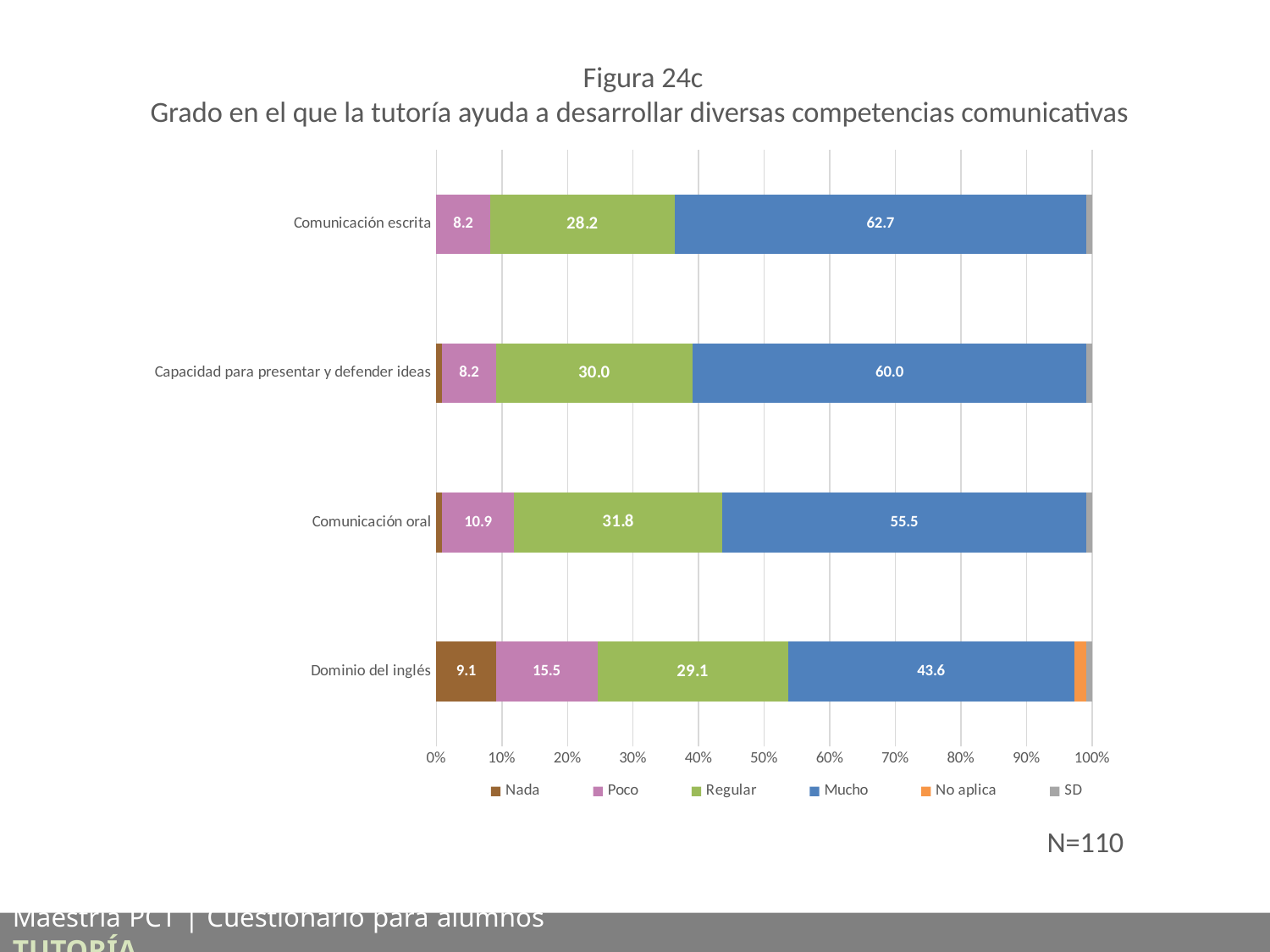
What is the value of "Mucho" for Comunicación escrita? 62.7 What is the sample size (N) stated on the slide? N=110 What is the value of "Poco" for Capacidad para presentar y defender ideas? 8.2 How many series does the legend list? 6 Which is larger: the "Regular" value for Comunicación oral or for Comunicación escrita? Comunicación oral How many categories are shown on the chart? 4 Which category has the lowest value for "Mucho"? Dominio del inglés What is the value of "Regular" for Comunicación oral? 31.8 Which category has the highest value for "Mucho"? Comunicación escrita What is the value of "Nada" for Dominio del inglés? 9.1 What kind of chart is shown on the slide? Stacked bar chart What is the difference between the "Mucho" values for Capacidad para presentar y defender ideas and Dominio del inglés? 16.4